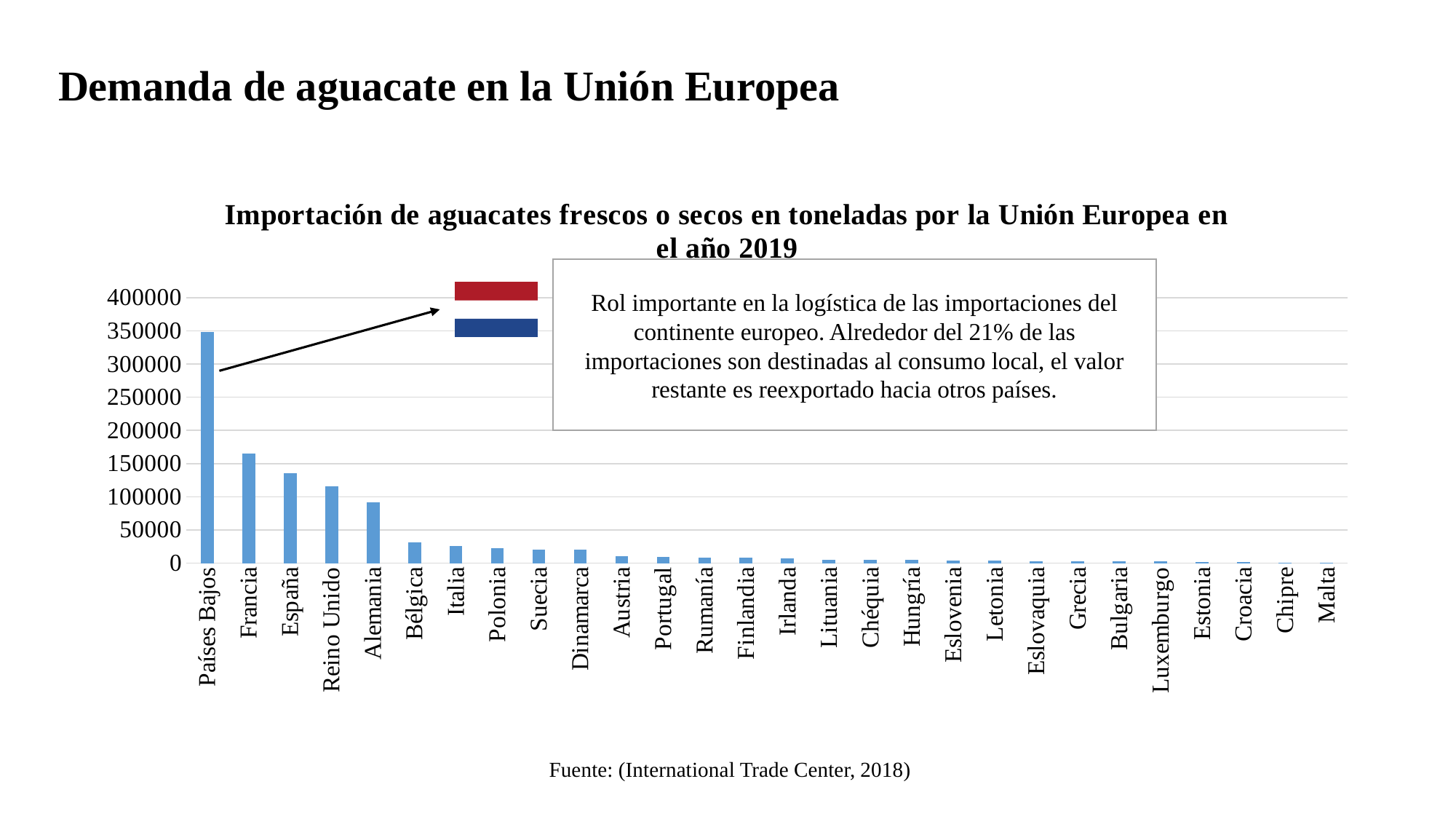
What kind of chart is shown on the slide? bar chart Is the value for Bélgica greater or less than 50000? less Is the value for Francia greater or less than 200000? less Which has a larger import value, Francia or España? Francia Is the value for Países Bajos greater or less than 300000? greater Do the values rise or fall moving from left to right along the x axis? fall What is the title of the chart? Importación de aguacates frescos o secos en toneladas por la Unión Europea en el año 2019 Which has a larger import value, Reino Unido or Alemania? Reino Unido Which country has the highest avocado import value in the chart? Países Bajos How many countries are shown on the x axis of the chart? 28